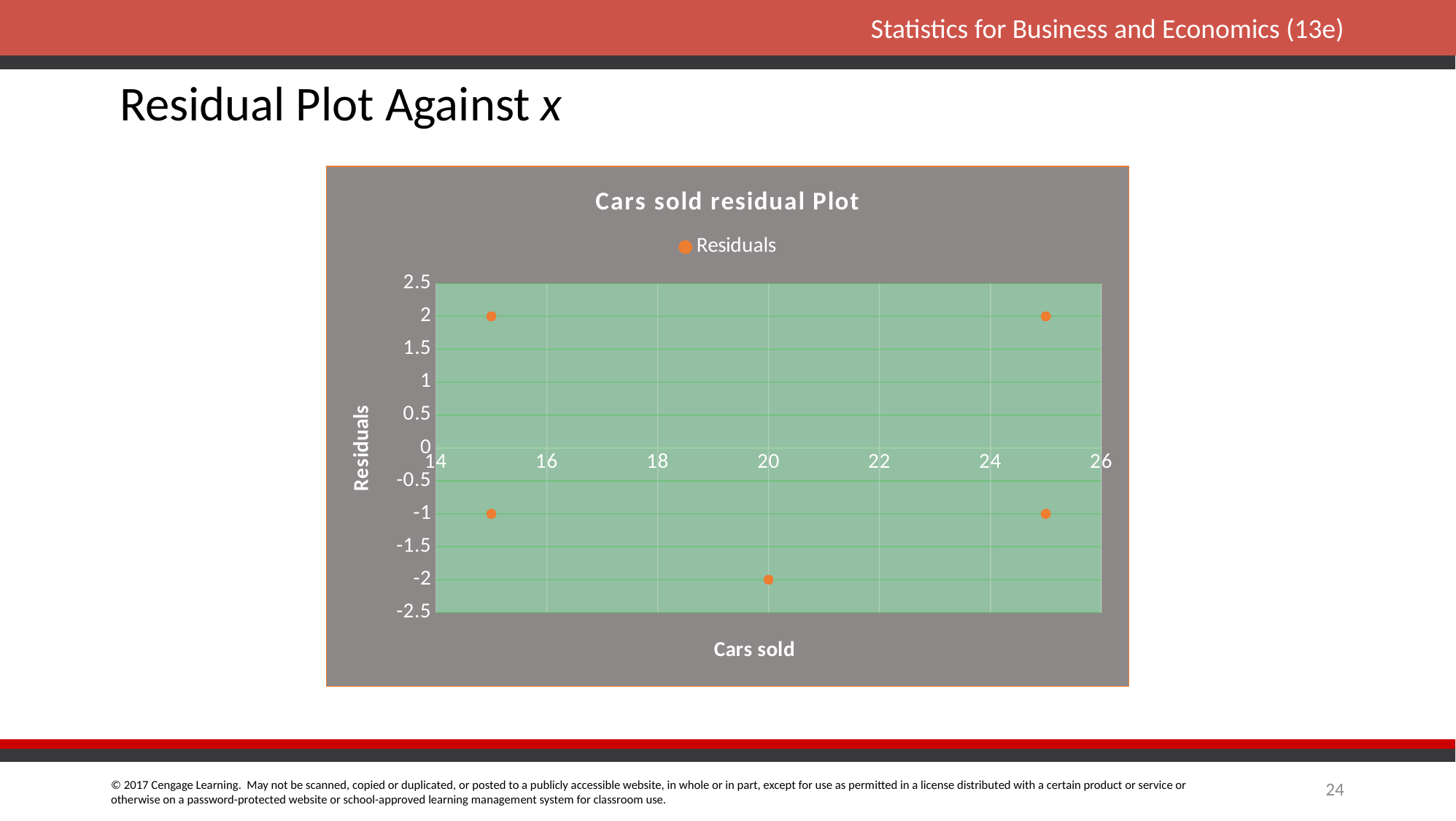
What is the label on the x axis of the chart? Cars sold What is the title of the chart? Cars sold residual Plot What kind of chart is shown on the slide? Scatter plot How many plotted points have a residual less than 0? 3 How many data points are plotted in the chart? 5 How many plotted points have a residual greater than 0? 2 What is the highest residual value plotted in the chart? 2 What is the residual for the point at 20 cars sold? -2 What is the lowest residual value plotted in the chart? -2 How many series does the legend list? 1 What is the difference between the highest residual (2) and the lowest residual (-2) in the chart? 4 Is the residual for the point at 20 cars sold greater or less than 0? less